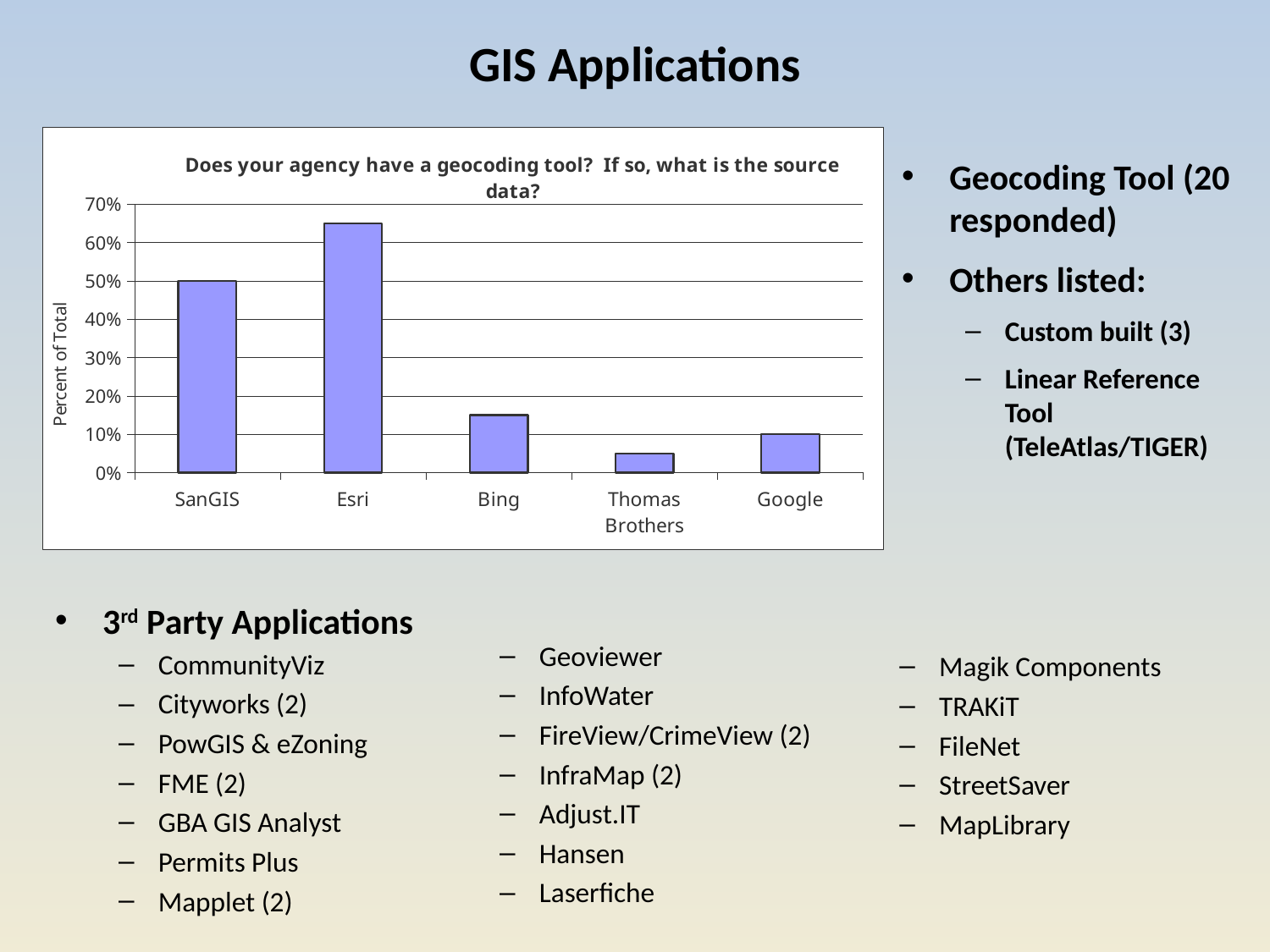
Which category has the highest value in the chart? Esri What is the label of the y axis of the chart? Percent of Total What is the value for SanGIS in the chart? 50% How many categories are shown on the x axis of the chart? 5 What is the value for Google in the chart? 10% What type of chart is shown on the slide? bar chart Which category has the lowest value in the chart? Thomas Brothers What is the title of the chart? Does your agency have a geocoding tool? If so, what is the source data? Is the value for Esri greater or less than 60%? greater Is the value for Thomas Brothers greater or less than 10%? less Which is larger, the value for SanGIS or the value for Bing? SanGIS Is the value for Bing greater or less than 20%? less